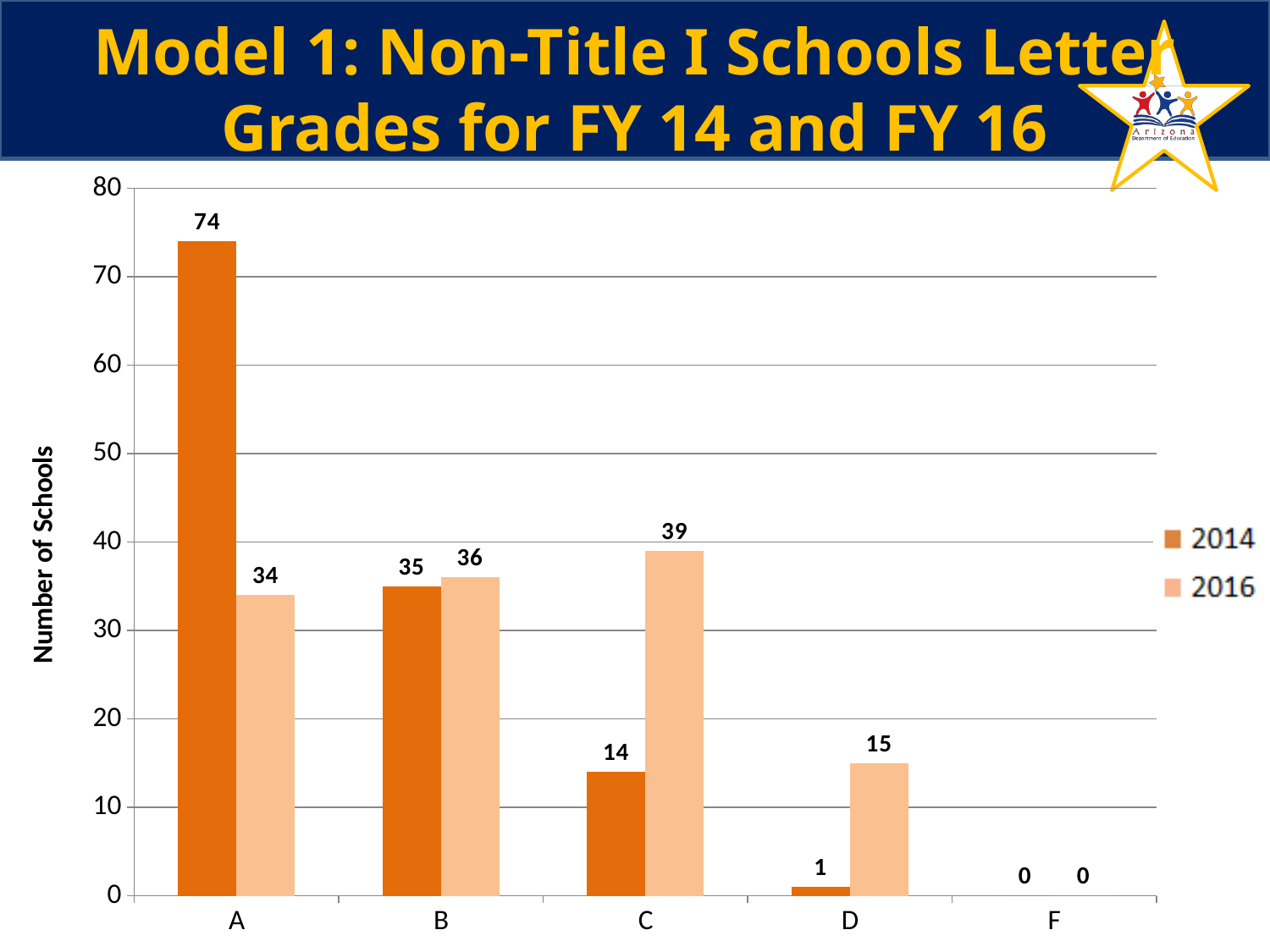
What is the difference between the 2016 and 2014 values for grade C? 25 What is the difference between the 2014 and 2016 values for grade A? 40 How many Non-Title I schools received a letter grade of C in 2016? 39 Which letter grade has the highest number of schools in the 2014 series? A How many letter grade categories are shown on the x axis? 5 Which letter grade has the lowest number of schools in the 2016 series? F Is the 2016 value for grade A greater or less than 40? less How many Non-Title I schools received a letter grade of A in 2014? 74 Which is larger for grade B: the 2014 value or the 2016 value? 2016 What kind of chart is shown on the slide? bar chart How many series does the legend list? 2 What is the value for grade D in the 2014 series? 1